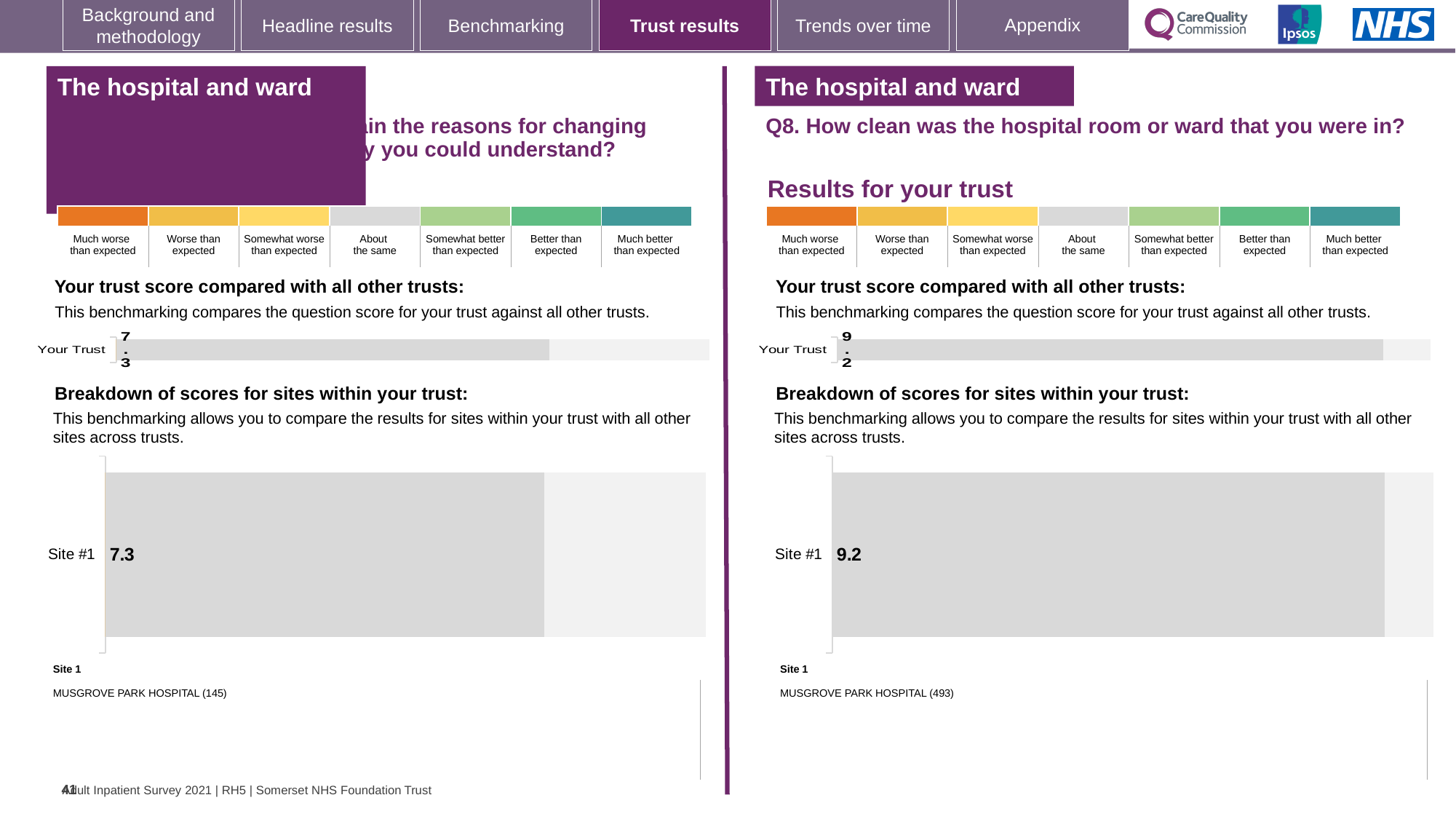
What is the difference between the Site #1 score on the right-hand panel (Q8) and the Site #1 score on the left-hand panel? 1.9 What kind of chart is used to show the Site #1 score on the right-hand panel (Q8)? bar chart On the left-hand panel, what is the 'Your Trust' score shown in the trust benchmarking bar? 7.3 On the right-hand panel (Q8), what is the 'Your Trust' score shown in the trust benchmarking bar? 9.2 On the left-hand panel, which site name is listed under 'Site 1' below the breakdown chart? MUSGROVE PARK HOSPITAL (145) On the right-hand panel (Q8), is the 'Your Trust' score the same as the Site #1 score? yes Which panel shows the higher Site #1 score, the left-hand panel or the right-hand panel (Q8)? the right-hand panel (Q8) On the right-hand panel (Q8), which site name is listed under 'Site 1' below the breakdown chart? MUSGROVE PARK HOSPITAL (493) On the left-hand panel, what score is shown for Site #1 in the breakdown of scores for sites within your trust? 7.3 On the right-hand panel (Q8), what score is shown for Site #1 in the breakdown of scores for sites within your trust? 9.2 How many sites are shown in the breakdown of scores chart on the left-hand panel? 1 How many sites are shown in the breakdown of scores chart on the right-hand panel (Q8)? 1